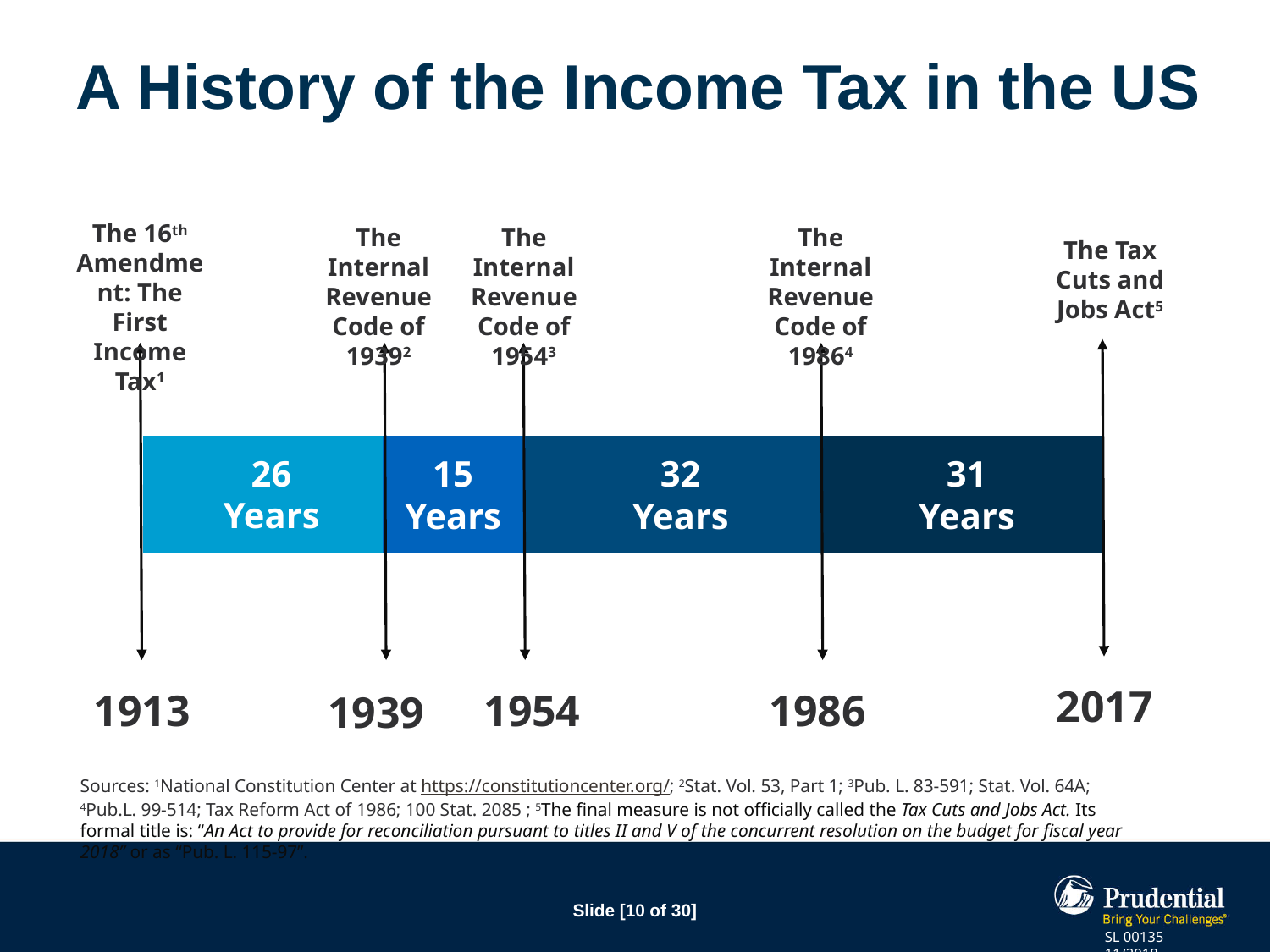
In what year does the timeline place the Tax Cuts and Jobs Act? 2017 What is the difference in years between the longest interval and the shortest interval on the timeline? 17 years What is the title of the slide? A History of the Income Tax in the US How many years are shown between the 16th Amendment and the Internal Revenue Code of 1939? 26 Years Which interval on the timeline is the shortest? 15 Years (1939 to 1954) What is the total number of years covered by the four intervals on the timeline? 104 years How many years are shown between the Internal Revenue Code of 1939 and the Internal Revenue Code of 1954? 15 Years How many years are shown between the Internal Revenue Code of 1986 and the Tax Cuts and Jobs Act? 31 Years Which interval is longer: 1913 to 1939 or 1986 to 2017? 1986 to 2017 (31 Years) How many events are marked on the timeline? 5 Which interval on the timeline is the longest? 32 Years (1954 to 1986) What kind of chart is shown on the slide? A timeline